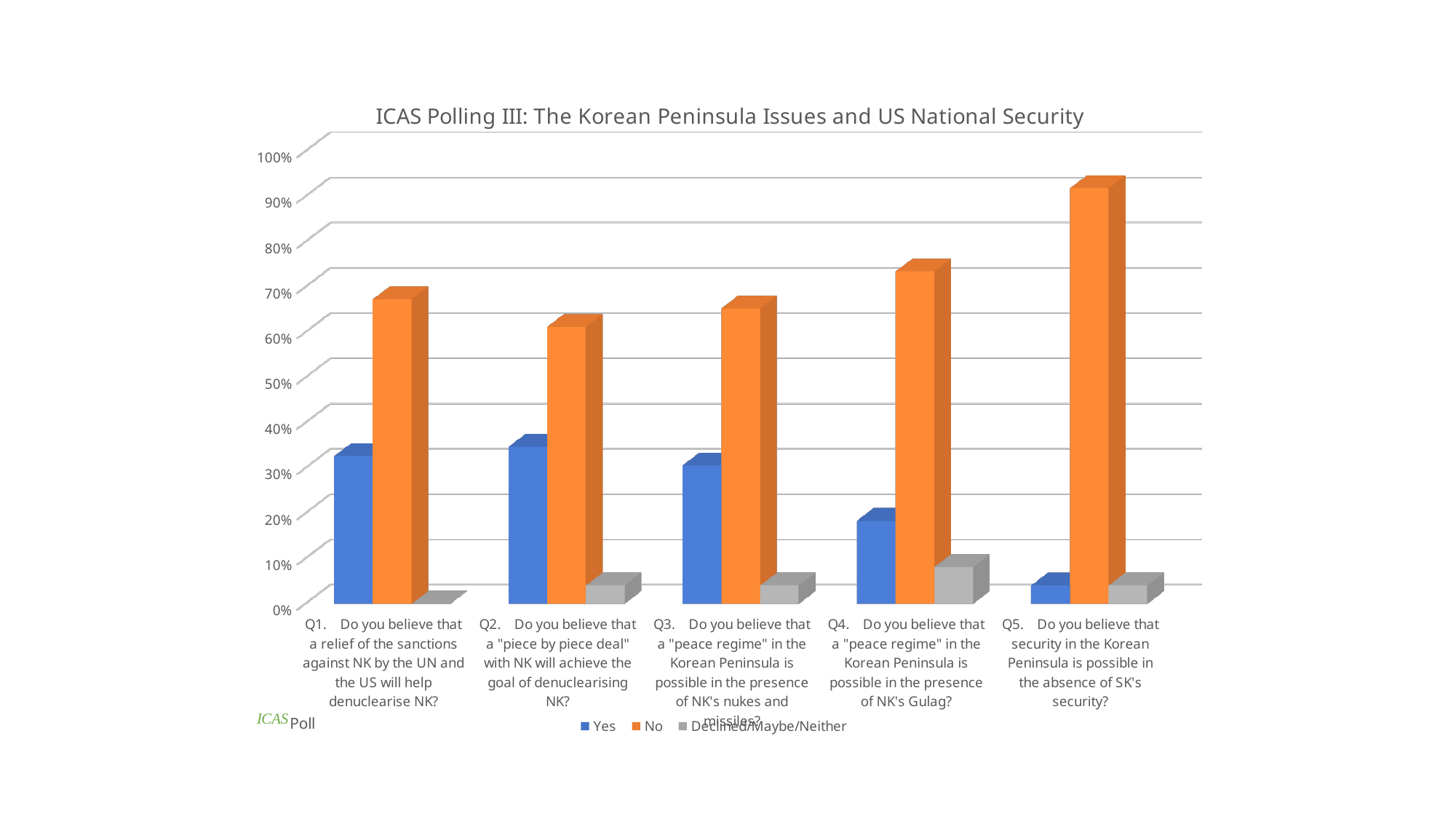
How many series does the legend list? 3 Is the "Yes" value for Q1 greater or less than 20%? greater What is the title of the chart? ICAS Polling III: The Korean Peninsula Issues and US National Security For which question is the "Declined/Maybe/Neither" response highest? Q4 What colour represents the "No" series in the legend? Orange For which question is the "No" response highest? Q5 What kind of chart is shown on the slide? Bar chart Is the "No" value for Q5 greater or less than 80%? greater For which question is the "Yes" response lowest? Q5 Is the "Yes" value for Q4 greater or less than 30%? less For Q1, which is larger, the "Yes" response or the "No" response? No How many questions (categories) are plotted along the x axis? 5